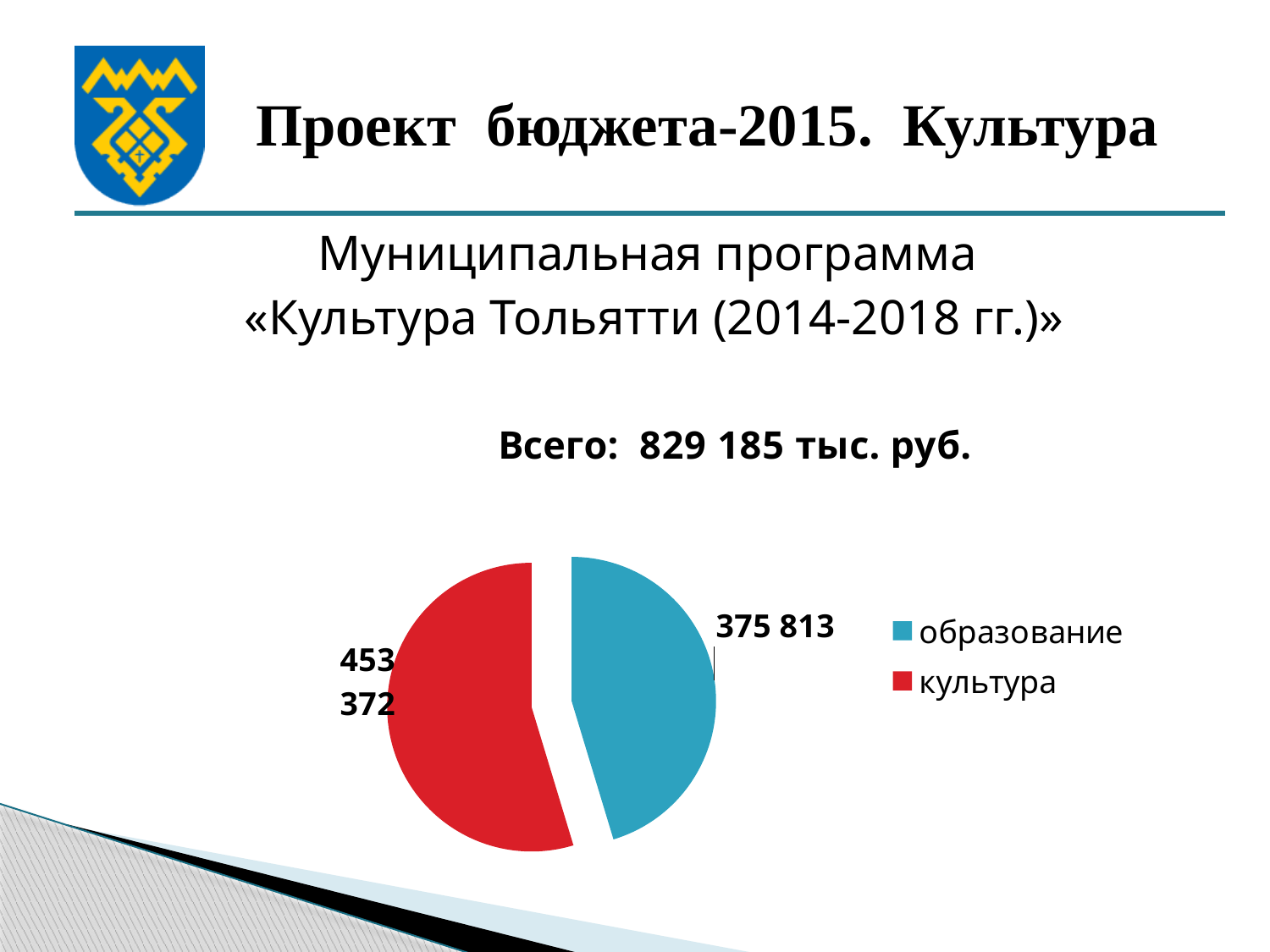
What colour is the slice for образование? blue What colour is the slice for культура? red Which category has the smallest slice in the pie chart? образование Which category has the largest slice in the pie chart? культура How many entries does the legend list? 2 Which is larger, the value for культура or the value for образование? культура How many slices does the pie chart have? 2 What is the value for образование in the pie chart? 375 813 What kind of chart is shown on the slide? pie chart What total amount is stated above the pie chart? 829 185 тыс. руб. What is the value for культура in the pie chart? 453 372 What is the difference between the values for культура and образование? 77 559